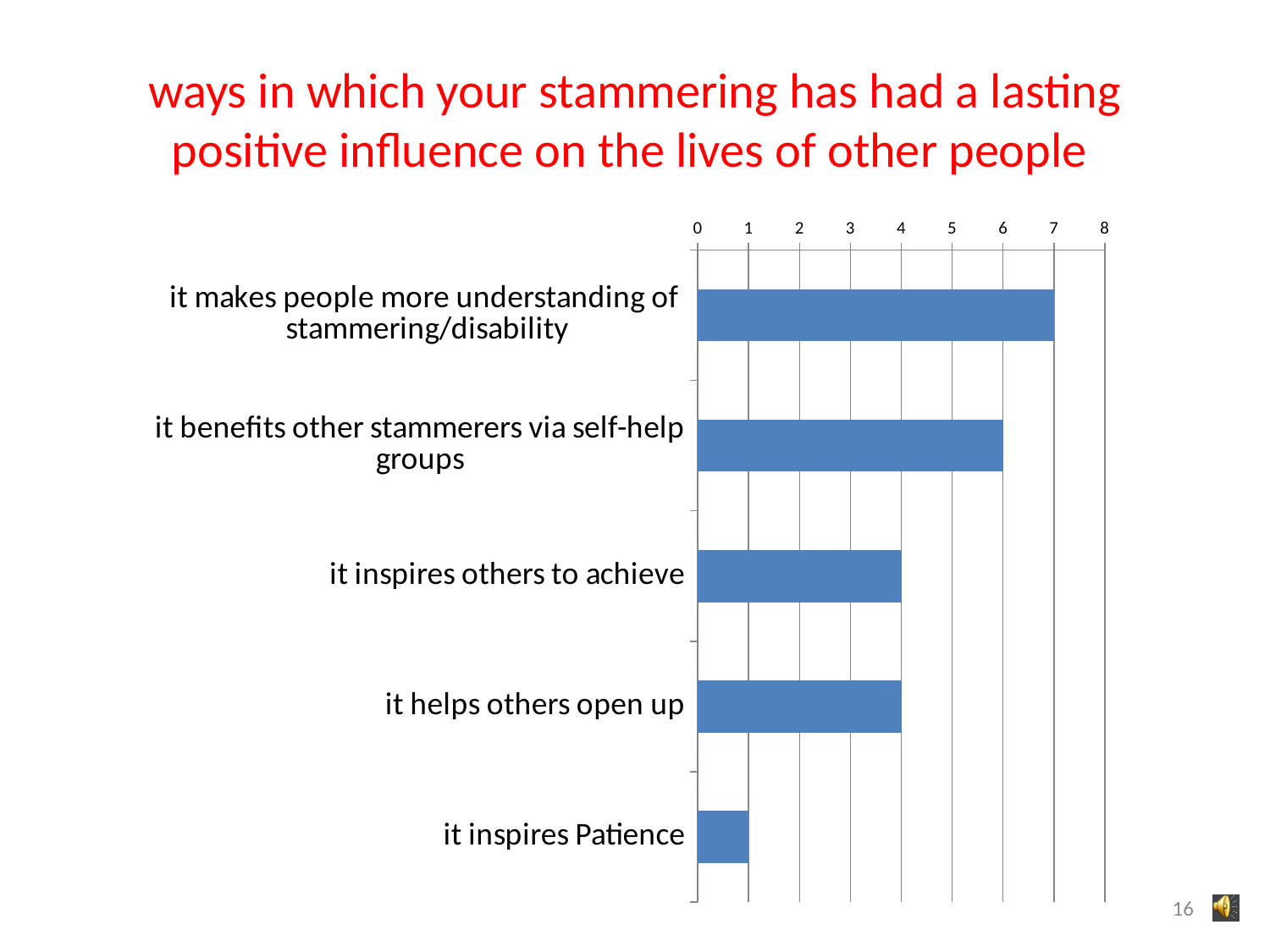
Which category has the highest value? it makes people more understanding of stammering/disability What is the value for "it benefits other stammerers via self-help groups"? 6 What is the value for "it makes people more understanding of stammering/disability"? 7 Is the value for "it inspires others to achieve" greater or less than 5? less What is the title of the slide containing the chart? ways in which your stammering has had a lasting positive influence on the lives of other people What is the difference between the values for "it makes people more understanding of stammering/disability" and "it inspires others to achieve"? 3 What is the value for "it inspires Patience"? 1 What is the value for "it helps others open up"? 4 Which category has the lowest value? it inspires Patience Which is larger: the value for "it benefits other stammerers via self-help groups" or the value for "it helps others open up"? it benefits other stammerers via self-help groups What kind of chart is shown on the slide? bar chart How many categories are plotted in the chart? 5